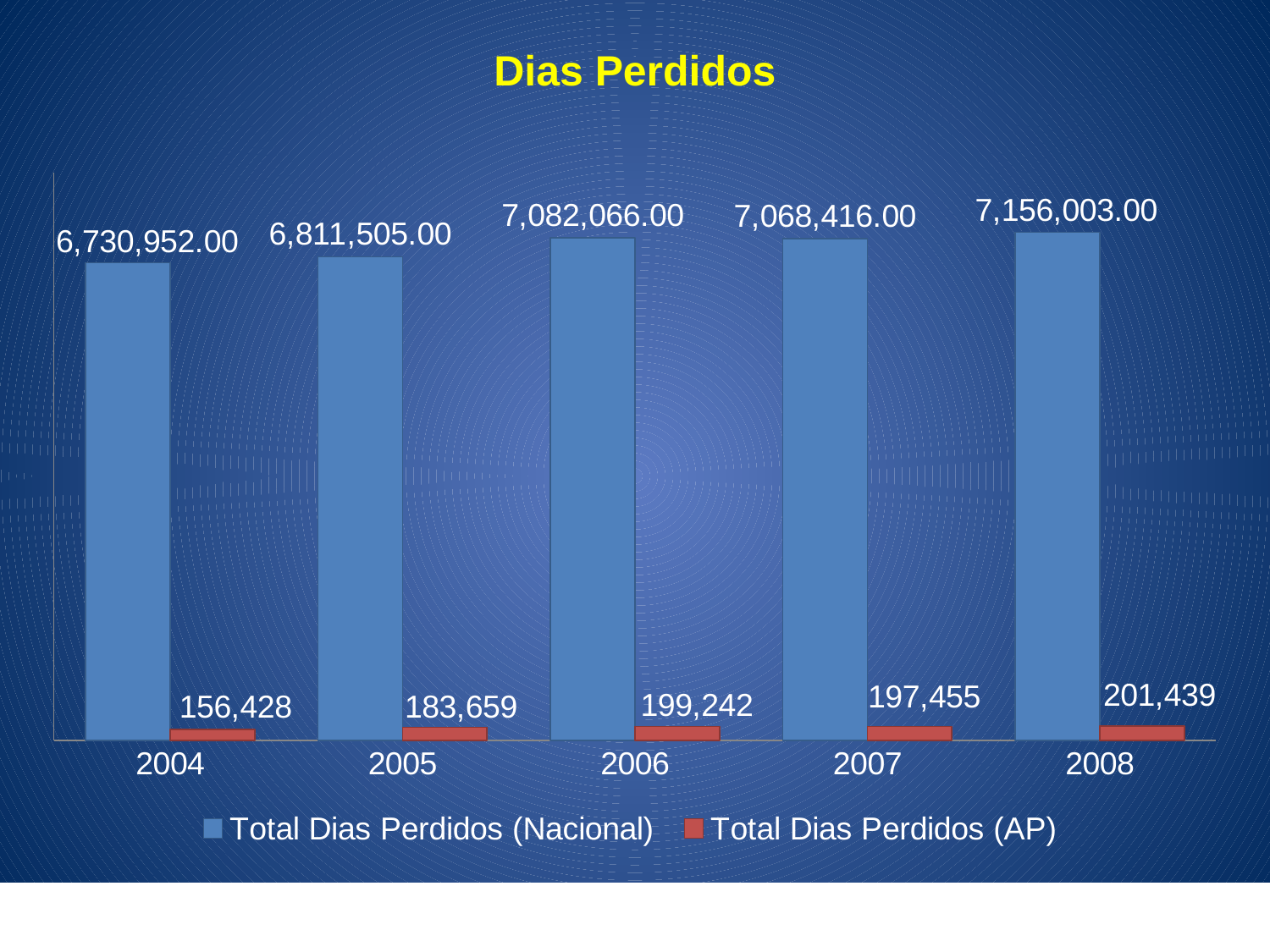
Which year has the highest value for Total Dias Perdidos (Nacional)? 2008 How many years are shown on the x axis? 5 Which is larger, Total Dias Perdidos (AP) in 2006 or in 2007? 2006 What is the value of Total Dias Perdidos (Nacional) for 2006? 7,082,066.00 What is the title of the chart? Dias Perdidos What is the difference between Total Dias Perdidos (Nacional) in 2008 and in 2004? 425,051.00 Which colour represents Total Dias Perdidos (AP) in the chart? Red Which year has the lowest value for Total Dias Perdidos (AP)? 2004 How many series does the legend list? 2 What is the value of Total Dias Perdidos (AP) for 2005? 183,659 What type of chart is shown on the slide? Bar chart What is the difference between Total Dias Perdidos (AP) in 2008 and in 2004? 45,011